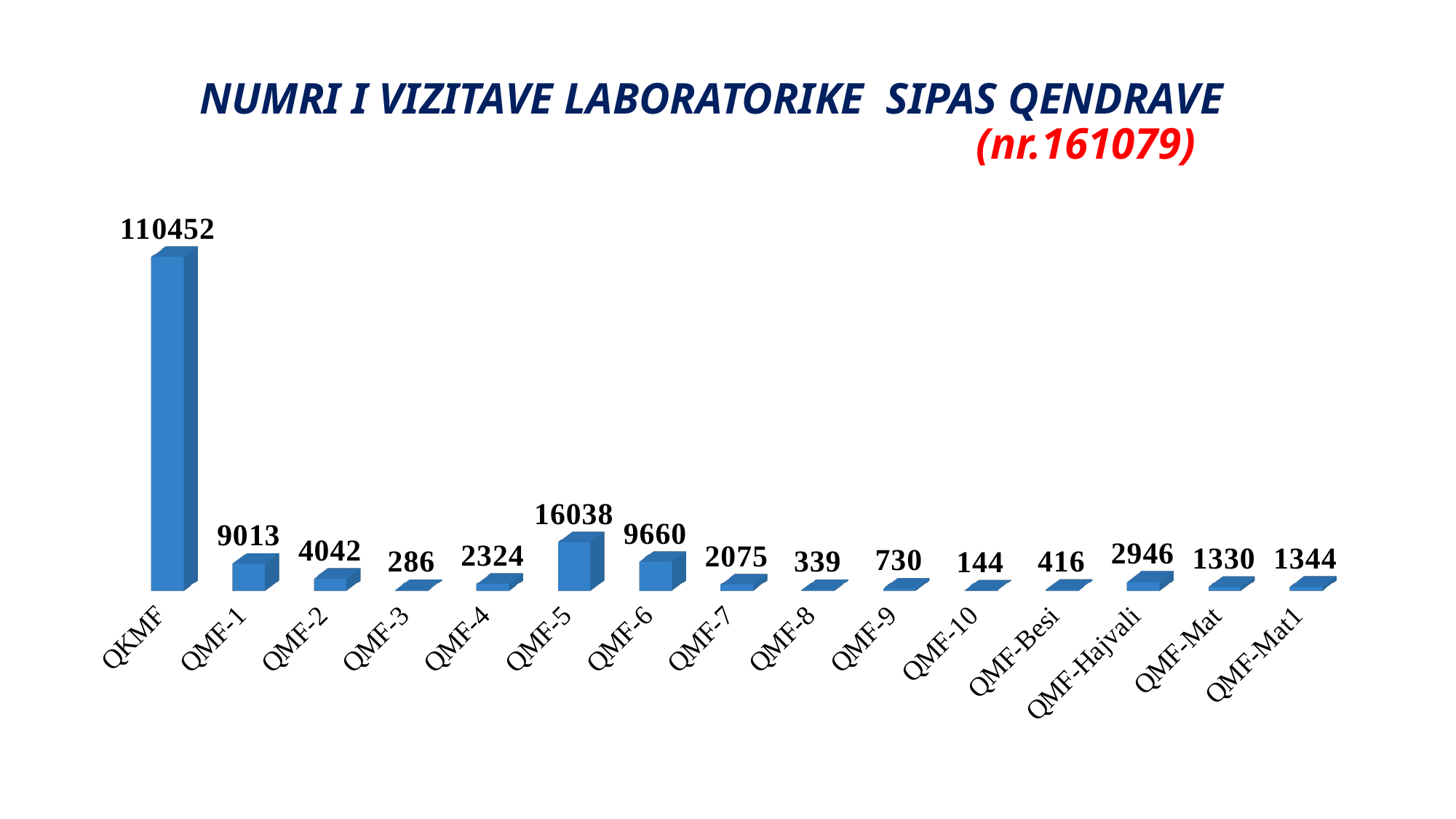
What is the difference between the values for QMF-5 and QMF-6? 6378 What is the difference between the values for QMF-1 and QMF-2? 4971 Which category has the highest value? QKMF What total number is shown in red in the chart title? nr.161079 What is the value for QMF-Hajvali? 2946 What is the value for QKMF? 110452 What kind of chart is shown on the slide? Bar chart How many categories are shown on the x axis? 15 What is the value for QMF-Besi? 416 Which category has the lowest value? QMF-10 What is the value for QMF-5? 16038 Which has a larger value, QMF-6 or QMF-1? QMF-6